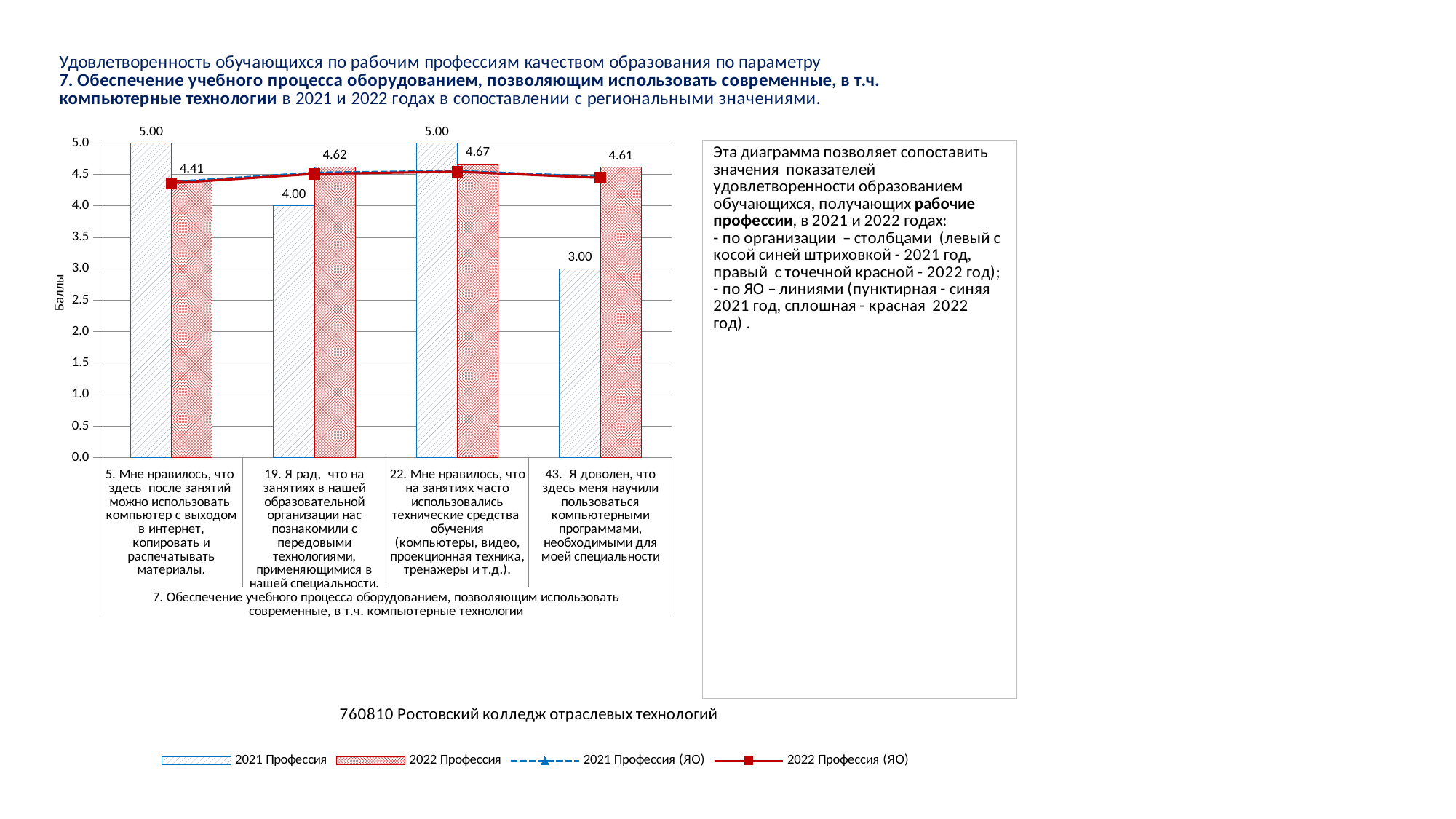
What is the title of the vertical axis of the chart? Баллы Which category has the highest 2022 Профессия bar? 22. Мне нравилось, что на занятиях часто использовались технические средства обучения What is the value of the 2021 Профессия bar for category 43 (Я доволен, что здесь меня научили пользоваться компьютерными программами...)? 3.00 Is the value of the 2022 Профессия (ЯО) line for category 5 greater or less than 4.0? greater How many series does the chart legend list? 4 What is the value of the 2022 Профессия bar for category 5 (Мне нравилось, что здесь после занятий можно использовать компьютер с выходом в интернет...)? 4.41 What is the difference between the 2022 Профессия and 2021 Профессия bars for category 43? 1.61 What is the value of the 2022 Профессия bar for category 19 (Я рад, что на занятиях в нашей образовательной организации нас познакомили с передовыми технологиями...)? 4.62 What is the difference between the 2021 Профессия and 2022 Профессия bars for category 5? 0.59 How many categories are shown on the x axis of the chart? 4 Which category has the lowest 2021 Профессия bar? 43. Я доволен, что здесь меня научили пользоваться компьютерными программами, необходимыми для моей специальности For category 19, which bar is larger: 2021 Профессия or 2022 Профессия? 2022 Профессия